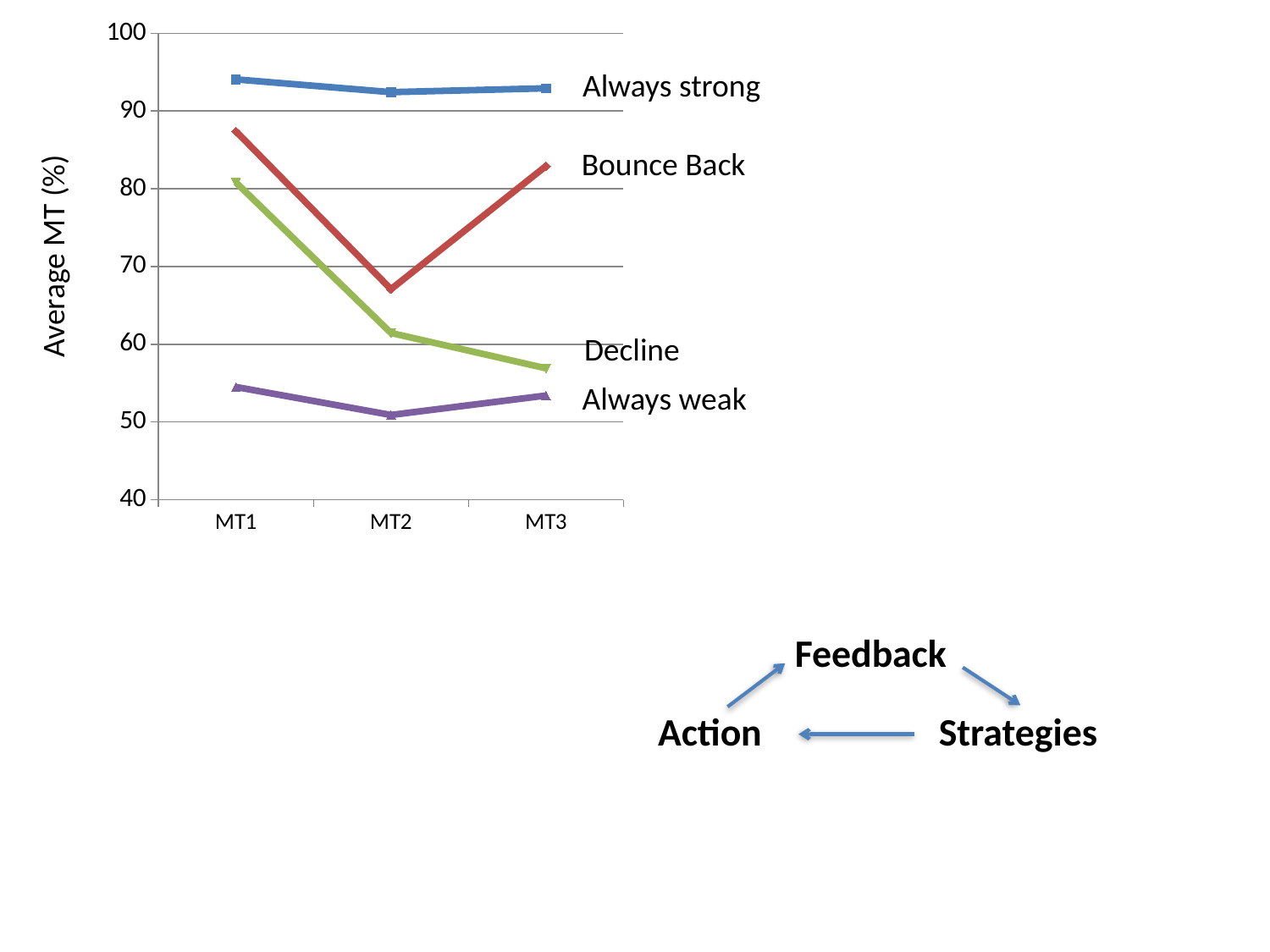
What is the label on the y axis of the chart? Average MT (%) Is the value for Bounce Back at MT2 greater or less than 70? less Which is larger at MT3, Bounce Back or Decline? Bounce Back What kind of chart is shown on the slide? line chart Is the value for Always strong at MT1 greater or less than 90? greater How many series are plotted on the chart? 4 Which series has the lowest value at MT2? Always weak Is the value for Decline at MT3 greater or less than 60? less Does the Decline series rise or fall from MT1 to MT3? fall Which series has the highest value at MT1? Always strong How many points are on the x axis of the chart? 3